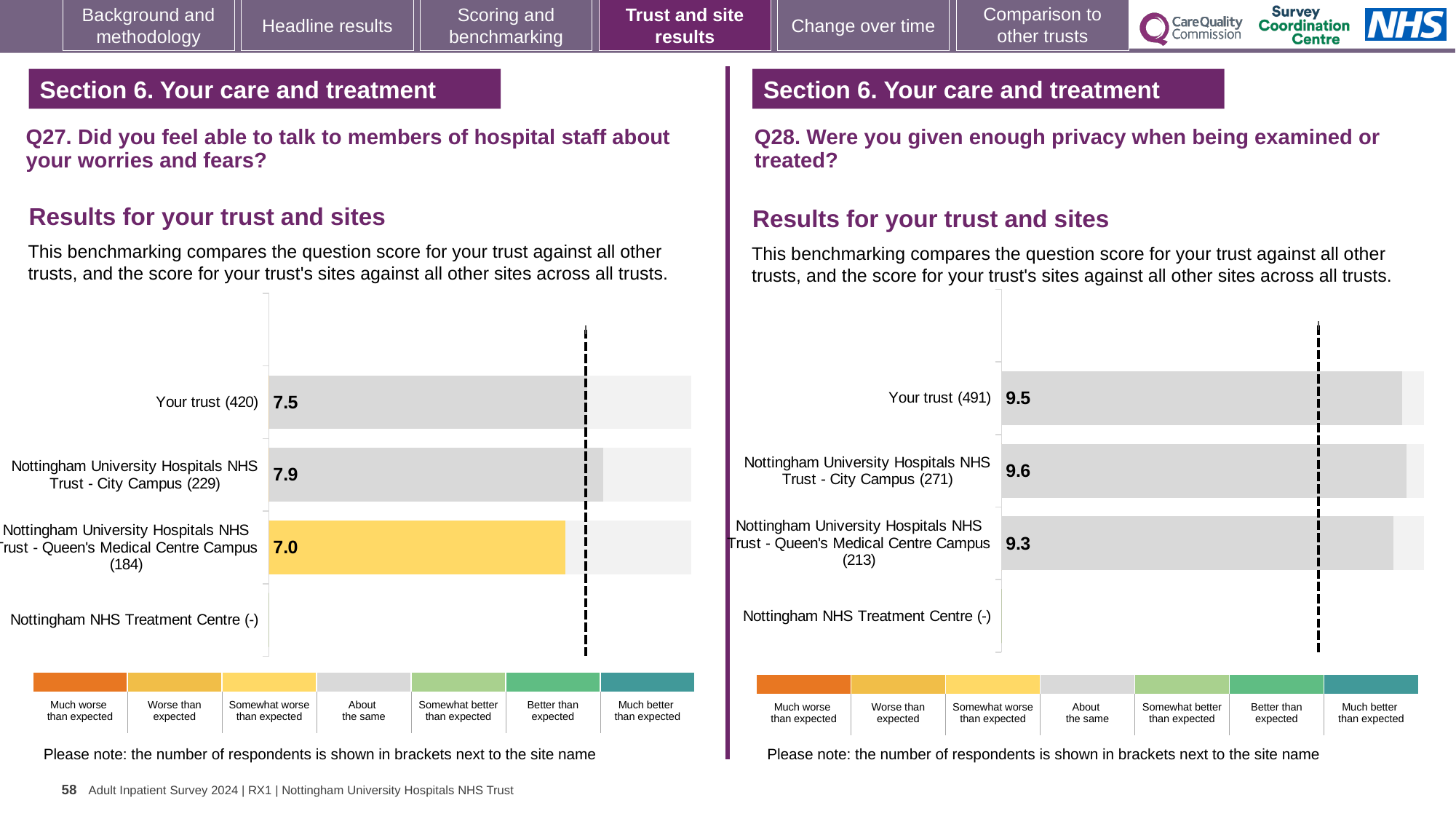
What type of chart is used for the Q28 results on the right? Bar chart In the Q27 chart on the left, what is the score for Nottingham University Hospitals NHS Trust - Queen's Medical Centre Campus (184)? 7.0 In the Q28 chart on the right, what is the score for Nottingham University Hospitals NHS Trust - City Campus (271)? 9.6 In the Q27 chart on the left, which bar is coloured yellow rather than grey? Nottingham University Hospitals NHS Trust - Queen's Medical Centre Campus (184) In the Q28 chart on the right, what is the difference between the Your trust score and the Queen's Medical Centre Campus score? 0.2 In the Q28 chart on the right, what is the score for Your trust (491)? 9.5 In the Q27 chart on the left, what is the score for Your trust (420)? 7.5 In the Q27 chart on the left, which has the larger score: Your trust or the Queen's Medical Centre Campus? Your trust In the Q27 chart on the left, which site or trust has the highest score? Nottingham University Hospitals NHS Trust - City Campus (229) In the Q27 chart on the left, what is the difference between the City Campus score and the Queen's Medical Centre Campus score? 0.9 In the Q28 chart on the right, how many respondents are shown in brackets for Your trust? 491 In the Q28 chart on the right, which site or trust has the lowest score? Nottingham University Hospitals NHS Trust - Queen's Medical Centre Campus (213)